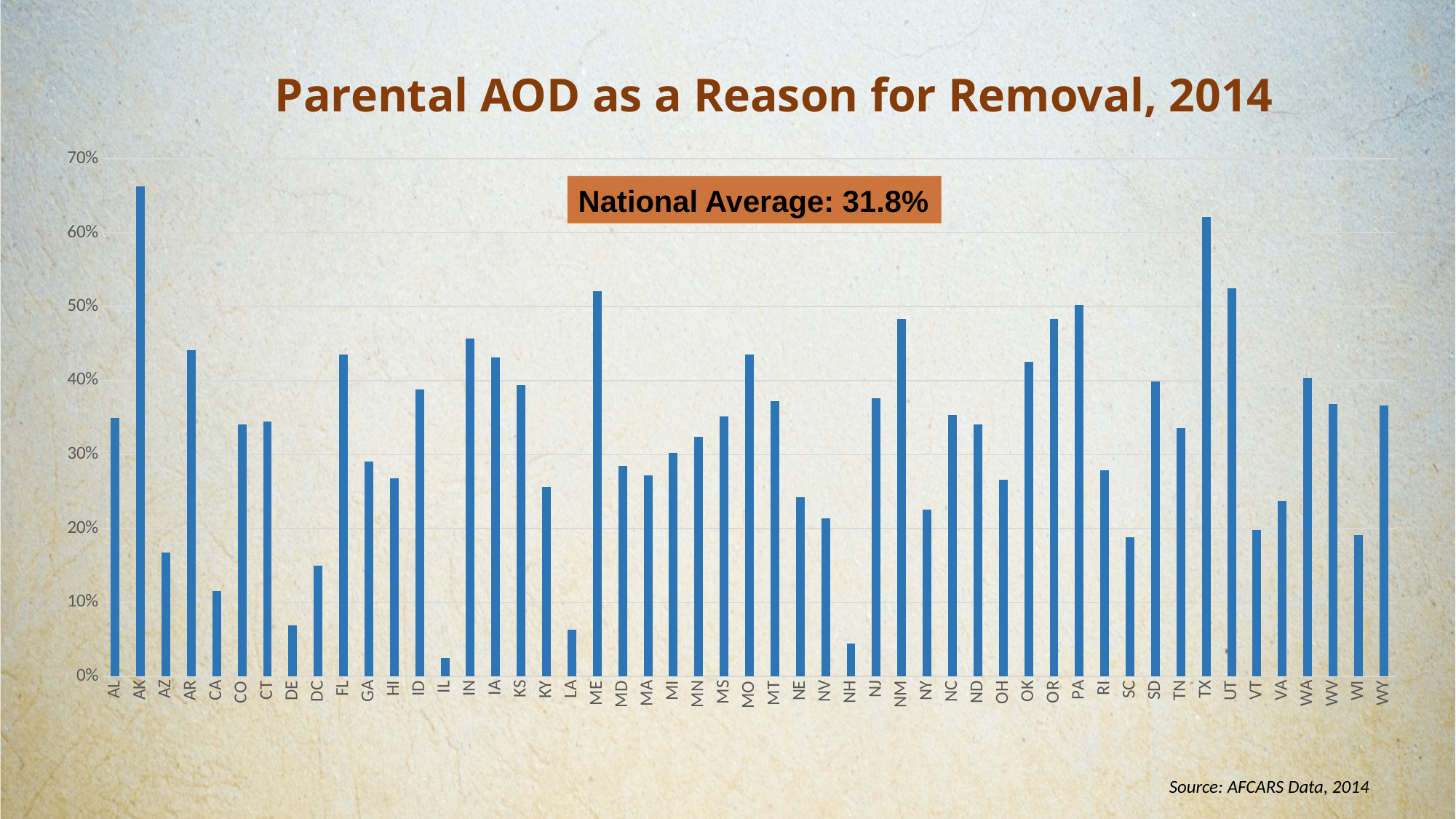
Which has a higher value, FL or GA? FL Which state has the lowest value for parental AOD as a reason for removal? IL Is the value for NM greater or less than 40%? greater Is the value for ME greater or less than 50%? greater Is the value for CA greater or less than 20%? less What kind of chart is shown on the slide? bar chart Which state has the highest value for parental AOD as a reason for removal? AK How many states/jurisdictions are shown on the x axis? 51 Which has a higher value, AK or TX? AK What national average is stated on the chart? 31.8%